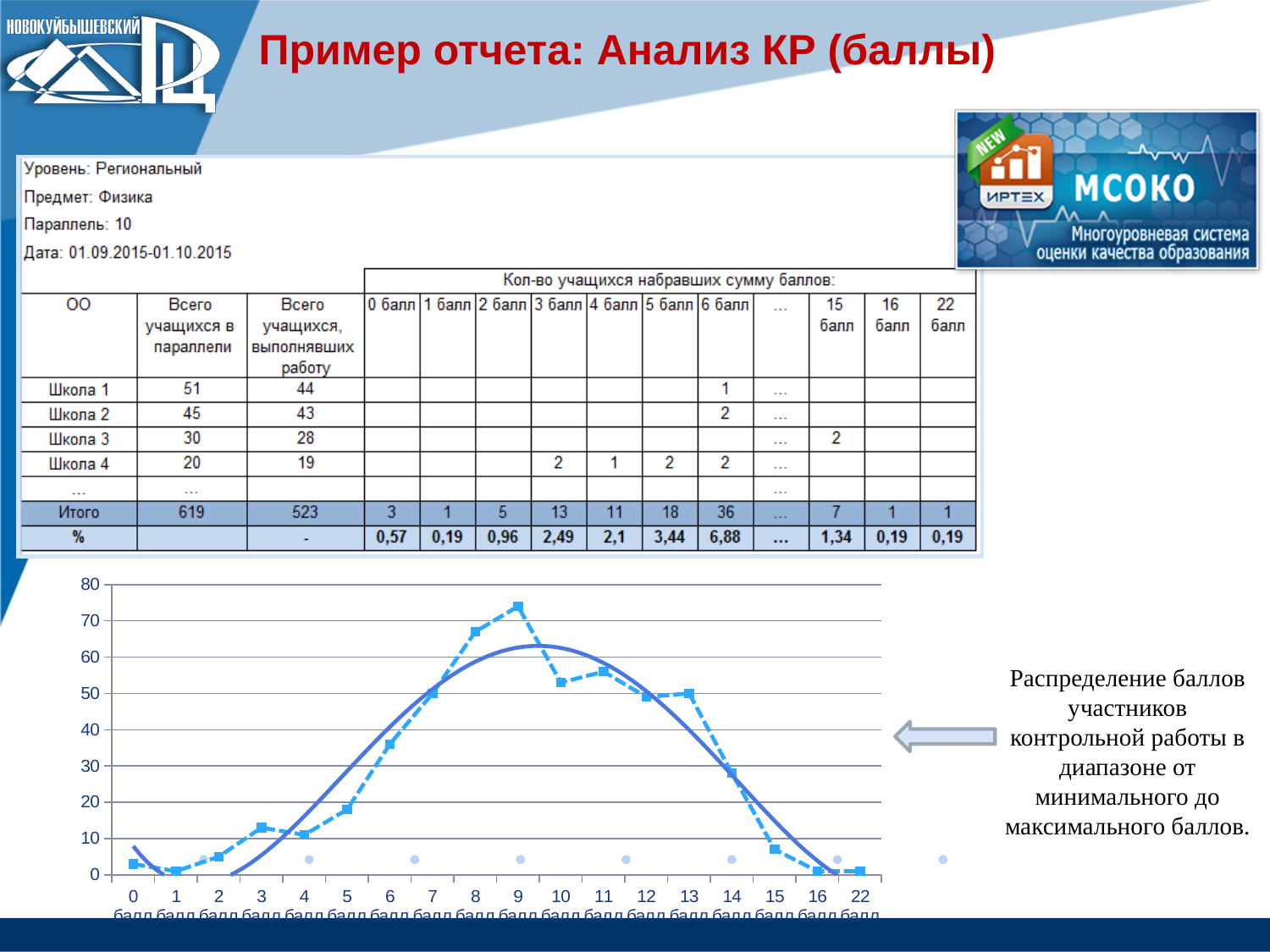
What kind of chart is shown at the bottom of the slide? line chart What is the highest value shown on the y axis of the chart? 80 How many score categories are shown along the x axis of the chart? 18 Is the value of the dashed line at 6 балл greater or less than 40? less On the dashed line, which is larger: the value at 8 балл or the value at 10 балл? 8 балл Which score category has the highest value on the dashed line with square markers? 9 балл Is the value of the dashed line at 8 балл greater or less than 60? greater Is the value of the dashed line at 15 балл greater or less than 10? less On the dashed line, which is larger: the value at 9 балл or the value at 6 балл? 9 балл Do the values of the dashed line rise or fall from 9 балл to 22 балл? fall